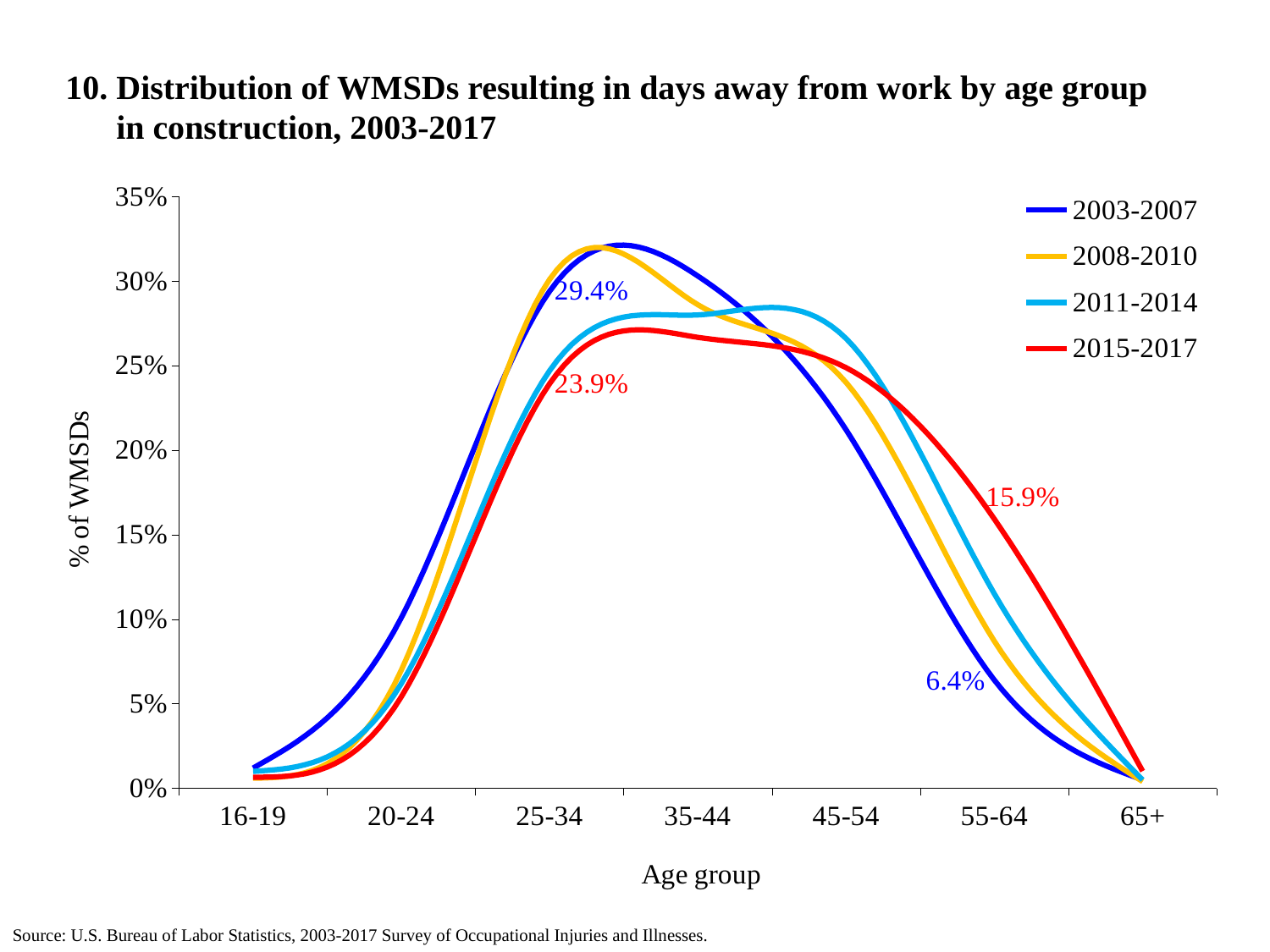
How many series does the legend list? 4 What value is labeled on the 2015-2017 line near the 25-34 age group? 23.9% What value is labeled on the 2015-2017 line near the 55-64 age group? 15.9% Is the value for 2011-2014 at the 45-54 age group greater or less than 25%? greater What kind of chart is shown on the slide? line chart What value is labeled on the 2003-2007 line near the 55-64 age group? 6.4% What is the difference between the labeled 2015-2017 value (15.9%) and the labeled 2003-2007 value (6.4%) near the 55-64 age group? 9.5 percentage points What value is labeled on the 2003-2007 line near the 25-34 age group? 29.4% Is the value for 2015-2017 at the 65+ age group greater or less than 5%? less Near the 55-64 age group, which series has the larger labeled value, 2015-2017 or 2003-2007? 2015-2017 How many age groups are shown on the x axis? 7 Does the 2003-2007 line rise or fall from the 45-54 age group to the 65+ age group? fall